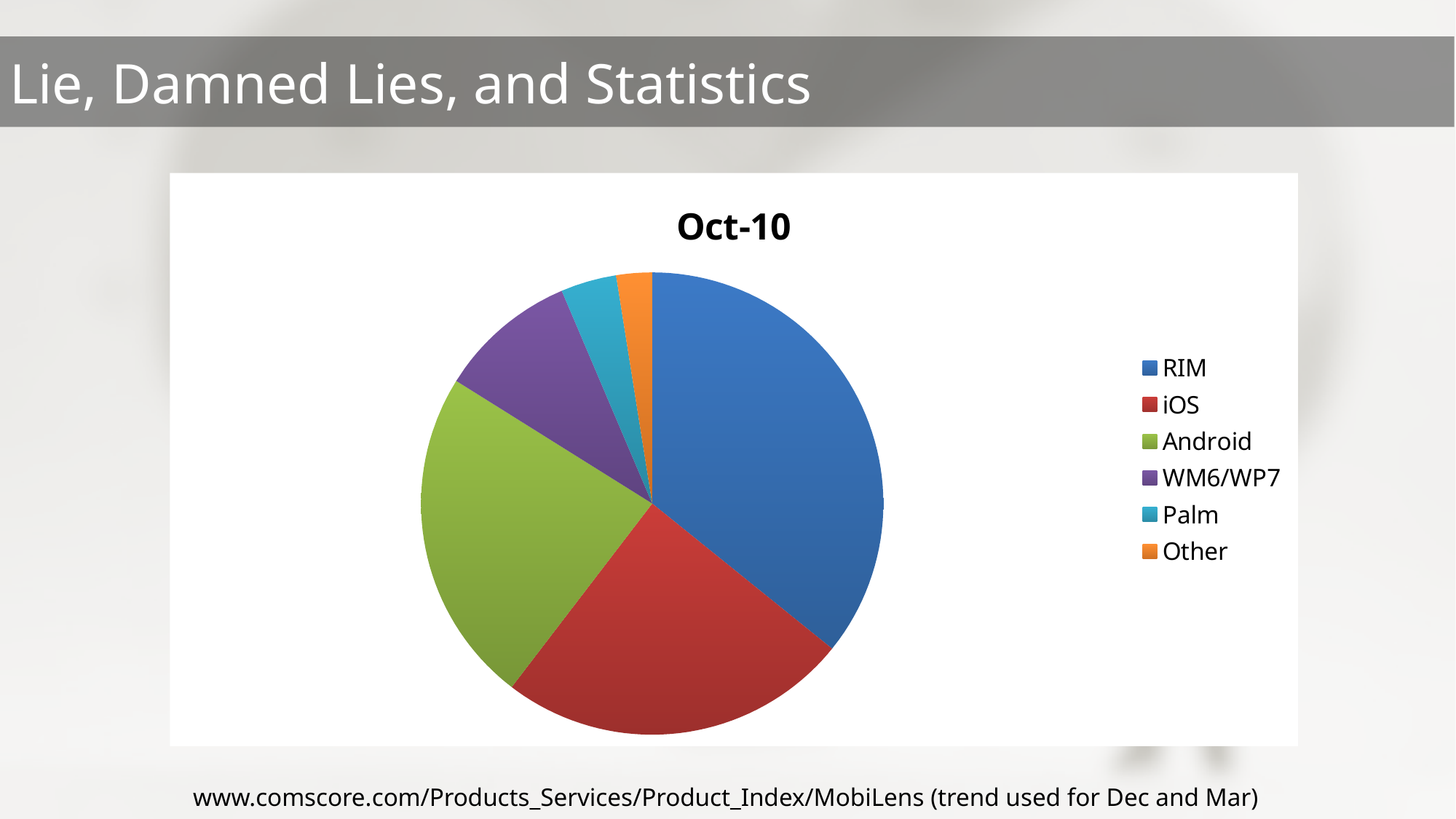
Which slice is larger, RIM or Android? RIM How many entries does the legend list? 6 Which slice is larger, WM6/WP7 or Palm? WM6/WP7 What is the title of the chart? Oct-10 Which slice is larger, Android or Other? Android Which category has the largest slice of the pie? RIM Which colour represents Android in the pie chart? green How many slices does the pie chart have? 6 Which category has the smallest slice of the pie? Other What kind of chart is shown on the slide? pie chart